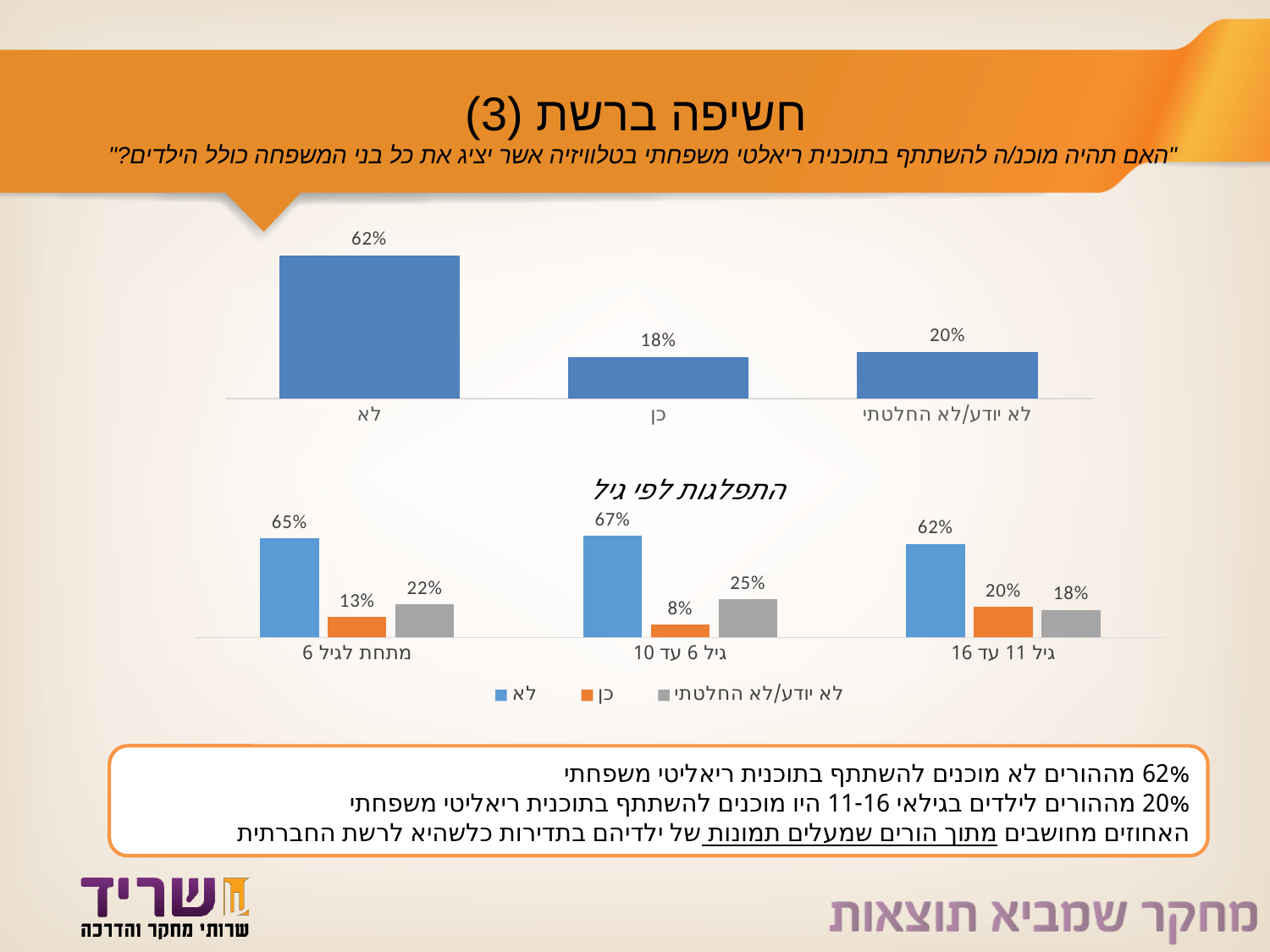
What kind of chart is the top chart on the slide? Bar chart In the top chart, which category has the lowest value? כן How many series does the legend of the chart titled "התפלגות לפי גיל" list? 3 In the chart titled "התפלגות לפי גיל", what is the value for "לא יודע/לא החלטתי" in the group "מתחת לגיל 6"? 22% In the top chart, what is the value for the category "לא"? 62% In the top chart, how many categories are shown? 3 In the chart titled "התפלגות לפי גיל", what is the value for "כן" in the group "גיל 6 עד 10"? 8% In the chart titled "התפלגות לפי גיל", which is larger for the group "גיל 11 עד 16": "כן" or "לא יודע/לא החלטתי"? כן In the chart titled "התפלגות לפי גיל", which age group has the highest value for "לא"? גיל 6 עד 10 In the top chart, what is the value for the category "כן"? 18% In the chart titled "התפלגות לפי גיל", what is the difference between the "לא" values for "גיל 6 עד 10" and "גיל 11 עד 16"? 5% In the top chart, what is the difference between the values for "לא" and "כן"? 44%